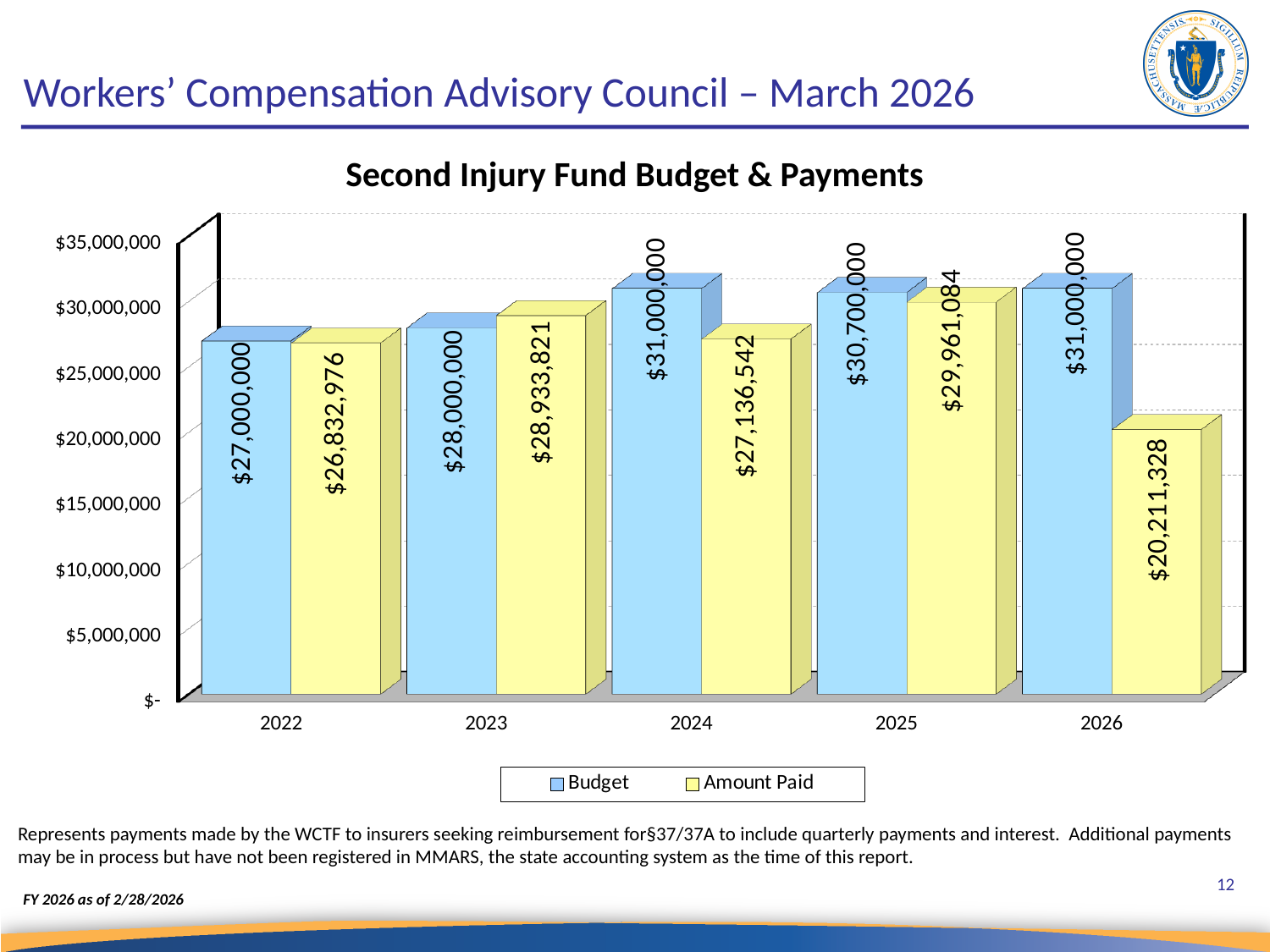
Is the Amount Paid for 2026 greater or less than $25,000,000? less What is the difference between the Budget and the Amount Paid in 2026? $10,788,672 What is the Amount Paid for 2026? $20,211,328 What kind of chart is shown on the slide? bar chart How many series does the legend list? 2 How many years are shown on the x axis? 5 In 2023, which is larger: the Budget or the Amount Paid? Amount Paid What is the Budget value for 2024? $31,000,000 Which year has the lowest Budget? 2022 Which year has the highest Amount Paid? 2025 What is the Amount Paid for 2023? $28,933,821 Which year has the lowest Amount Paid? 2026